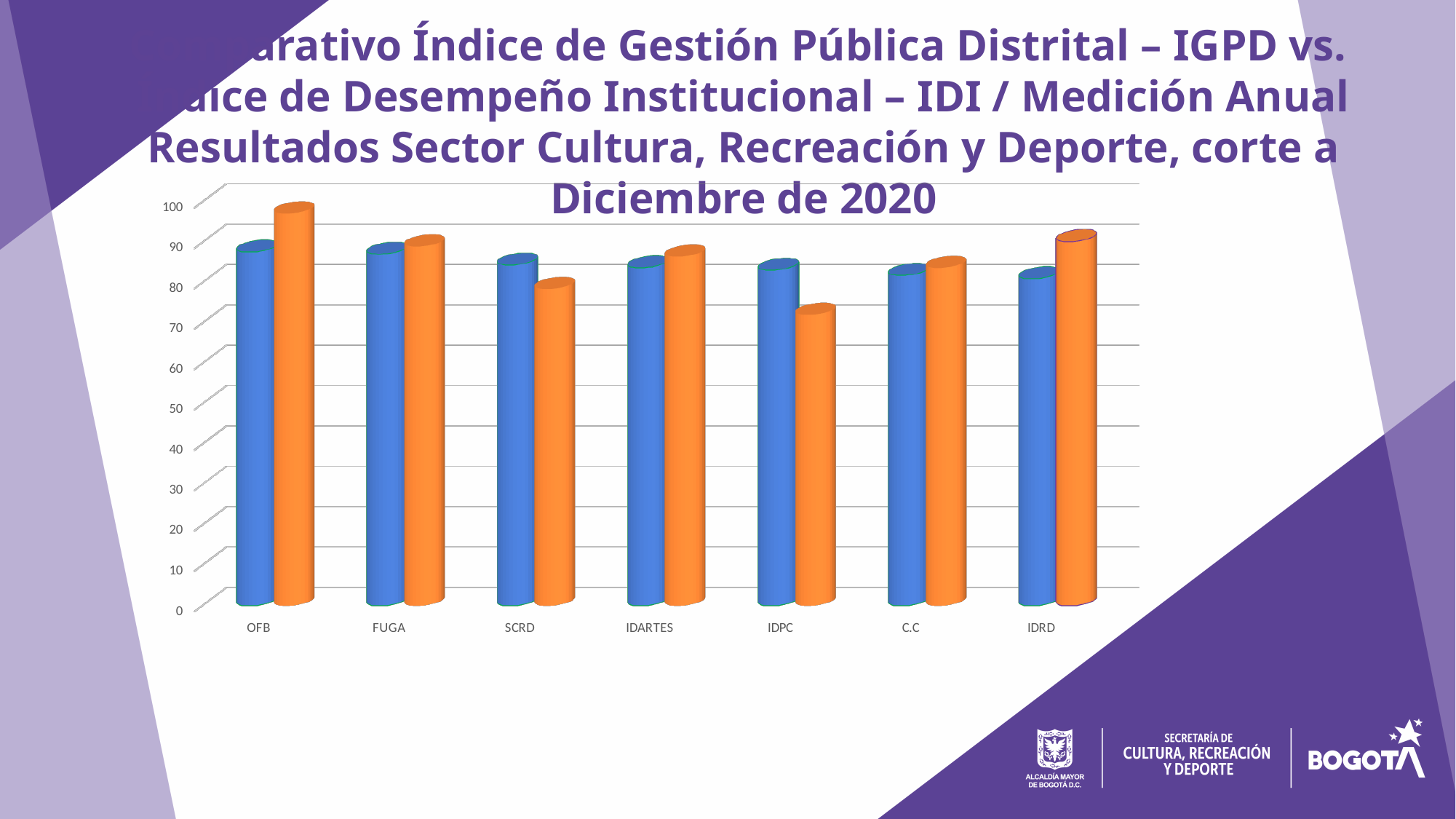
What cut-off date does the chart title give for the results? Diciembre de 2020 Is the orange bar for IDPC greater or less than 80? less What kind of chart is shown on the slide? Bar chart Is the blue bar for IDPC greater or less than 80? greater For OFB, which bar is taller, the blue one or the orange one? Orange Is the orange bar for IDRD greater or less than 80? greater Which entity has the highest orange bar in the chart? OFB How many entities (categories) are shown on the x axis of the chart? 7 Which entity has the lowest orange bar in the chart? IDPC For SCRD, which bar is taller, the blue one or the orange one? Blue For IDPC, which bar is taller, the blue one or the orange one? Blue